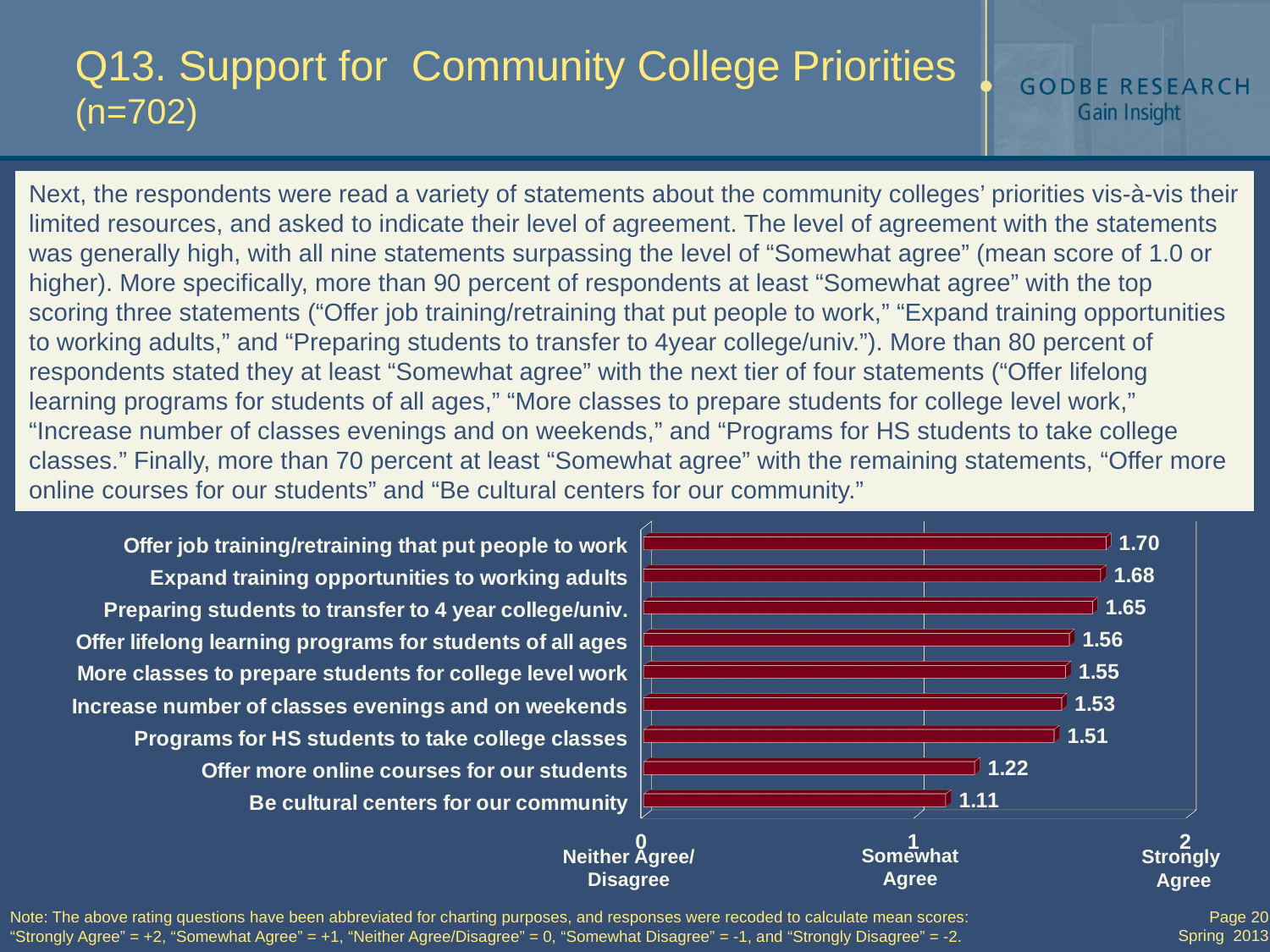
What is the difference between the mean scores for "Offer job training/retraining that put people to work" and "Be cultural centers for our community"? 0.59 What is the mean score for "Offer more online courses for our students"? 1.22 What is the difference between the mean scores for "Expand training opportunities to working adults" and "Offer more online courses for our students"? 0.46 Which statement has the lowest mean score? Be cultural centers for our community What kind of chart is shown on the slide? bar chart Which has a higher mean score: "Offer lifelong learning programs for students of all ages" or "Offer more online courses for our students"? Offer lifelong learning programs for students of all ages What is the mean score for "Be cultural centers for our community"? 1.11 Which statement has the highest mean score? Offer job training/retraining that put people to work Is the mean score for "Preparing students to transfer to 4 year college/univ." greater or less than 1? greater What is the mean score for "Offer job training/retraining that put people to work"? 1.70 How many statements are shown in the chart? 9 What is the mean score for "Programs for HS students to take college classes"? 1.51